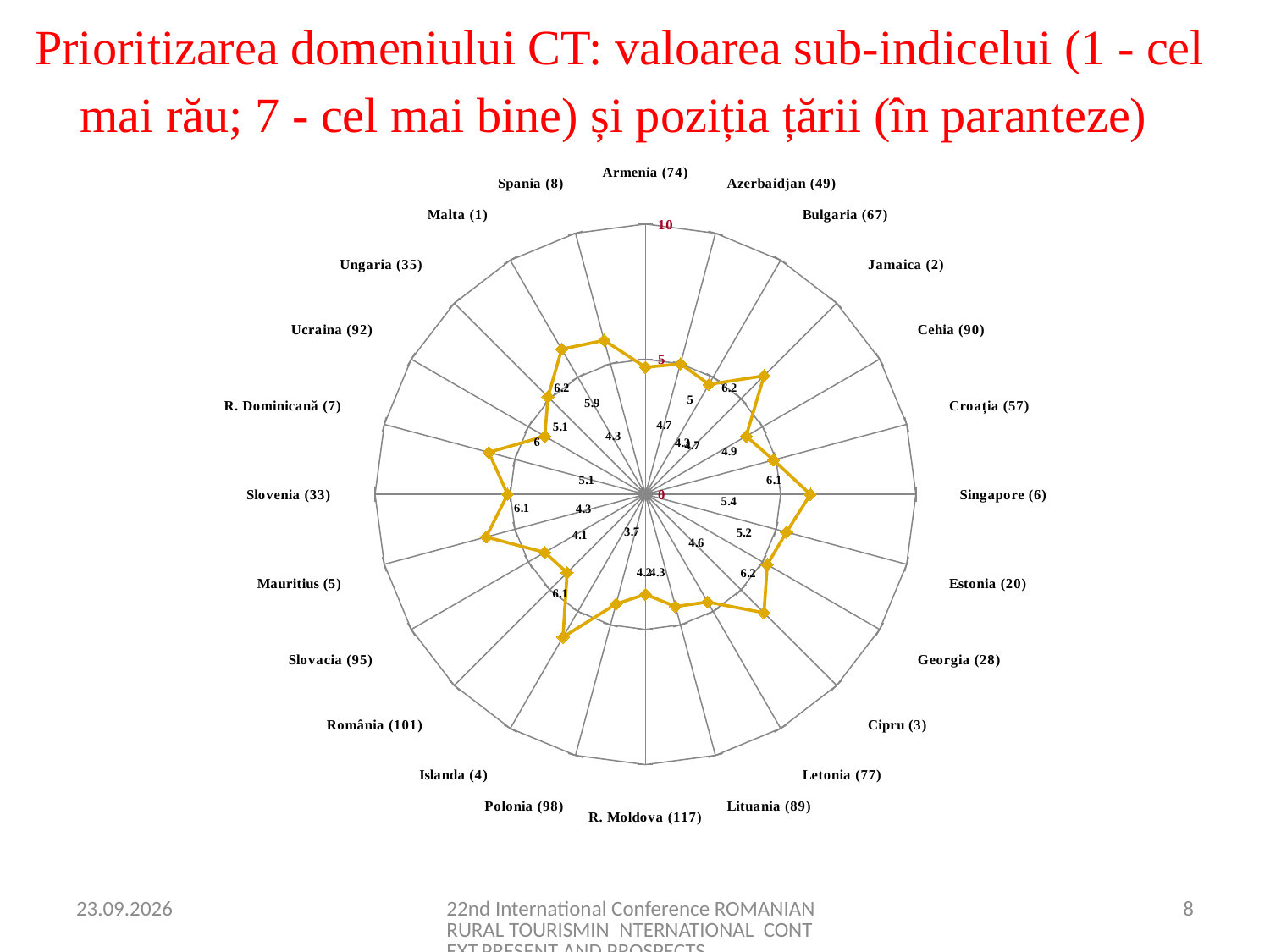
What is the sub-index value for Slovenia (33)? 5.1 Is the value for R. Moldova (117) greater or less than 5? less Which has a higher sub-index value, Malta (1) or Armenia (74)? Malta (1) What is the sub-index value for Mauritius (5)? 6.1 What is the maximum value shown on the radial axis of the chart? 10 Is the value for Singapore (6) greater or less than 5? greater What is the sub-index value for Malta (1)? 6.2 What type of chart is shown on the slide? Radar chart What is the difference between the sub-index values of Malta (1) and Armenia (74)? 1.5 What is the sub-index value for Armenia (74)? 4.7 What is the sub-index value for Spania (8)? 5.9 How many countries are plotted on the radar chart? 24